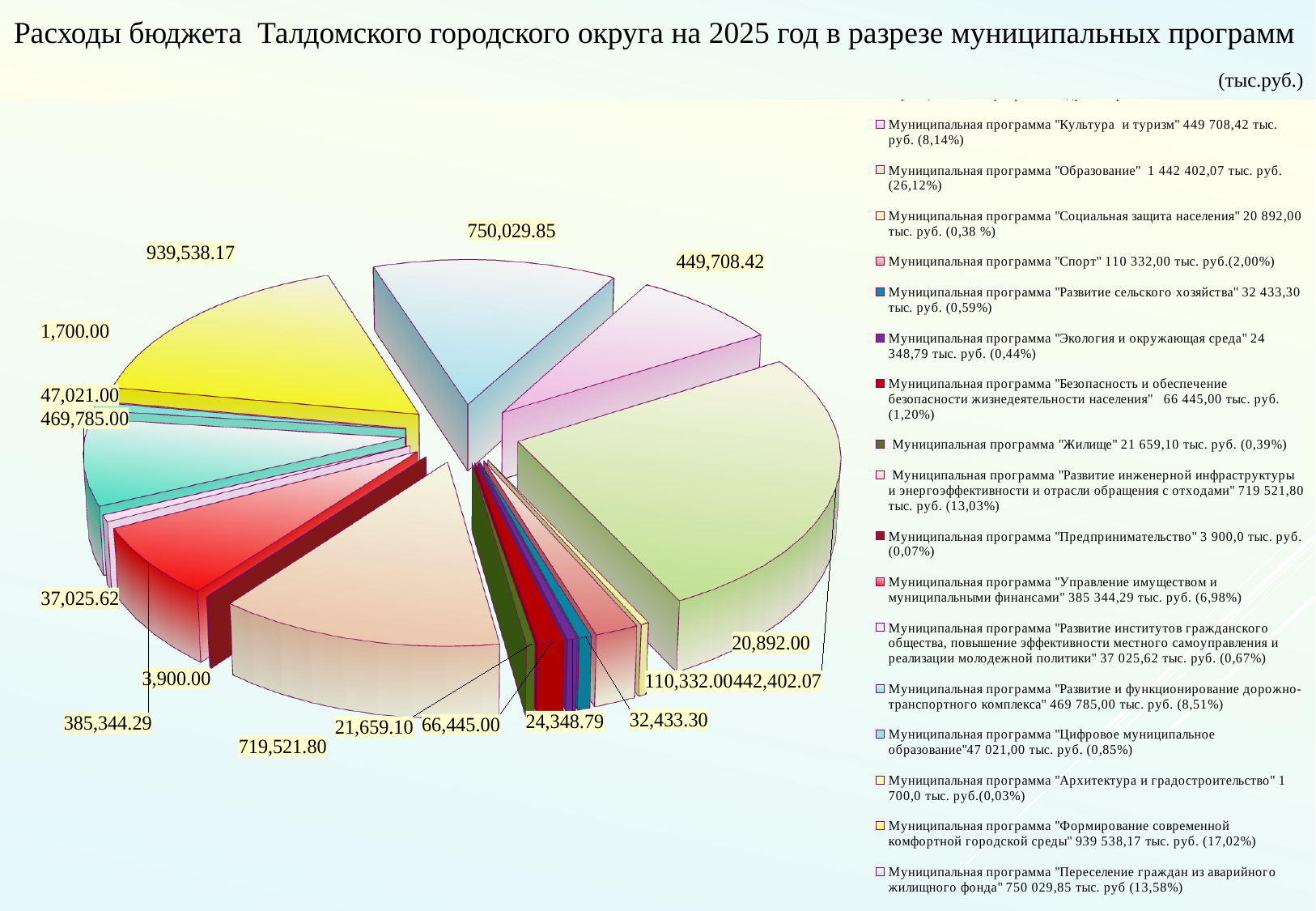
Which municipal program has the largest slice of the pie? Образование What is the value shown for the program "Переселение граждан из аварийного жилищного фонда"? 750,029.85 What share of the pie does the program "Формирование современной комфортной городской среды" account for, according to the legend? 17,02% In what units are the values on the chart expressed, according to the slide? тыс.руб. Which is larger: the value for "Переселение граждан из аварийного жилищного фонда" or the value for "Развитие инженерной инфраструктуры и энергоэффективности и отрасли обращения с отходами"? Переселение граждан из аварийного жилищного фонда What is the difference between the value for "Культура и туризм" and the value for "Управление имуществом и муниципальными финансами"? 64,364.13 Which municipal program has the smallest slice of the pie? Архитектура и градостроительство What is the value shown for the program "Спорт"? 110,332.00 What is the value shown for the program "Культура и туризм"? 449,708.42 What kind of chart is shown on the slide? pie chart What share of the pie does the program "Образование" account for, according to the legend? 26,12% What is the value shown for the program "Формирование современной комфортной городской среды"? 939,538.17